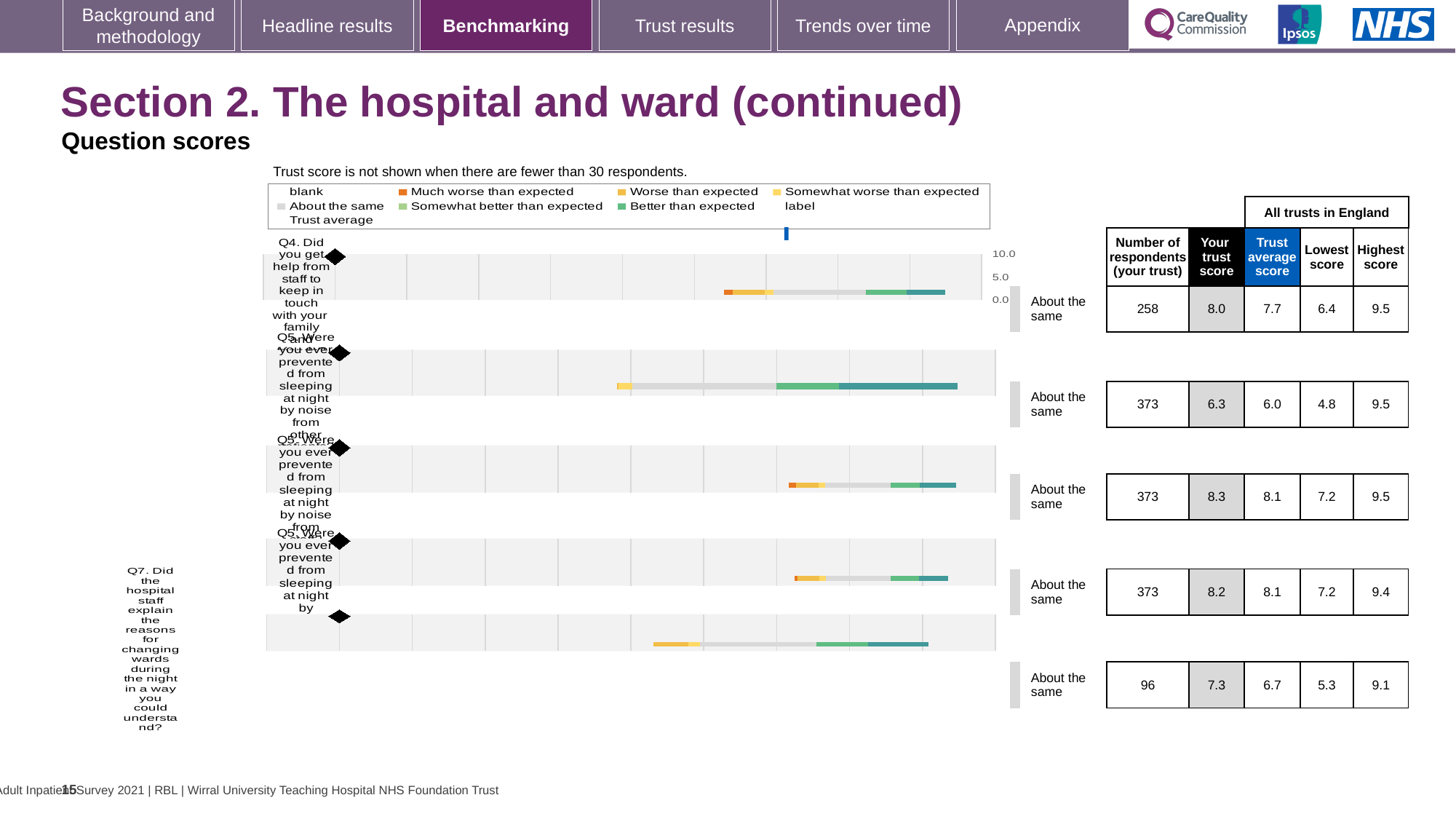
What is the lowest score across all trusts in England for the second bar from the top (Q5, noise from other patients)? 4.8 What is the trust average score for Q4 (help from staff to keep in touch with family and friends)? 7.7 For Q7, which is larger: the trust's score or the trust average score? the trust's score (7.3) How many respondents does the table show for Q7 (explaining reasons for changing wards during the night)? 96 How many question bars are plotted in the chart? 5 Which question has the fewest respondents in the table? Q7 What is the lowest score across all trusts in England for Q7 (explaining reasons for changing wards during the night)? 5.3 Which legend entry is shown in orange? Much worse than expected How many respondents does the table show for Q4 (help from staff to keep in touch with family and friends)? 258 What is the trust's score for Q4 (help from staff to keep in touch with family and friends)? 8.0 By how much does the trust's score for Q4 exceed the trust average score for Q4? 0.3 What kind of chart is shown on the slide? bar chart